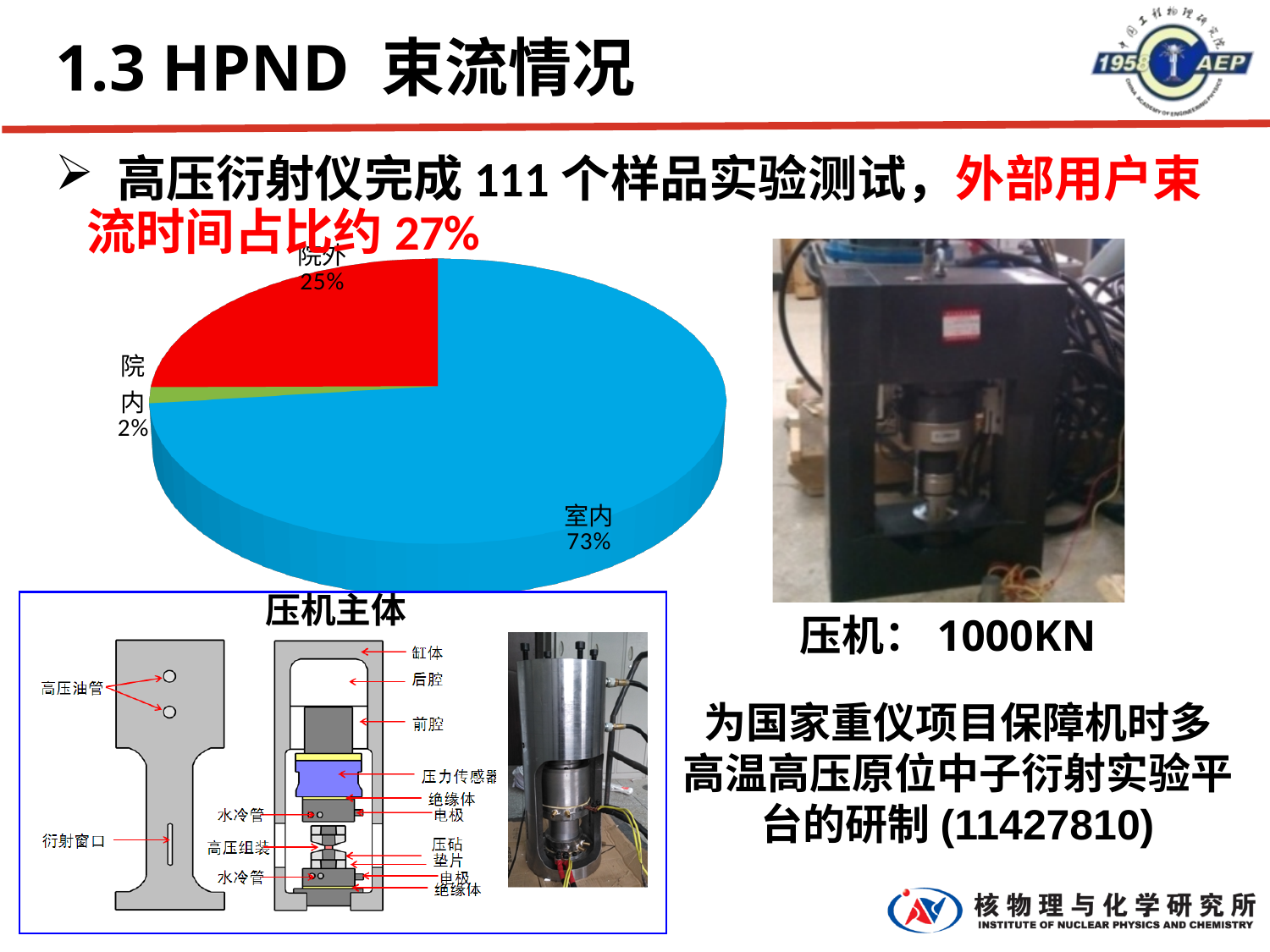
Which slice is larger, 院外 or 院内? 院外 Which category has the largest share of the pie chart? 室内 What type of chart is shown on the slide? pie chart What percentage does the 室内 slice represent in the pie chart? 73% What is the difference in percentage points between the 室内 and 院外 slices? 48 What is the combined share of the 院外 and 院内 slices? 27% What colour is the 室内 slice in the pie chart? blue What percentage does the 院内 slice represent in the pie chart? 2% What percentage does the 院外 slice represent in the pie chart? 25% How many slices does the pie chart have? 3 What colour is the 院外 slice in the pie chart? red Which category has the smallest share of the pie chart? 院内